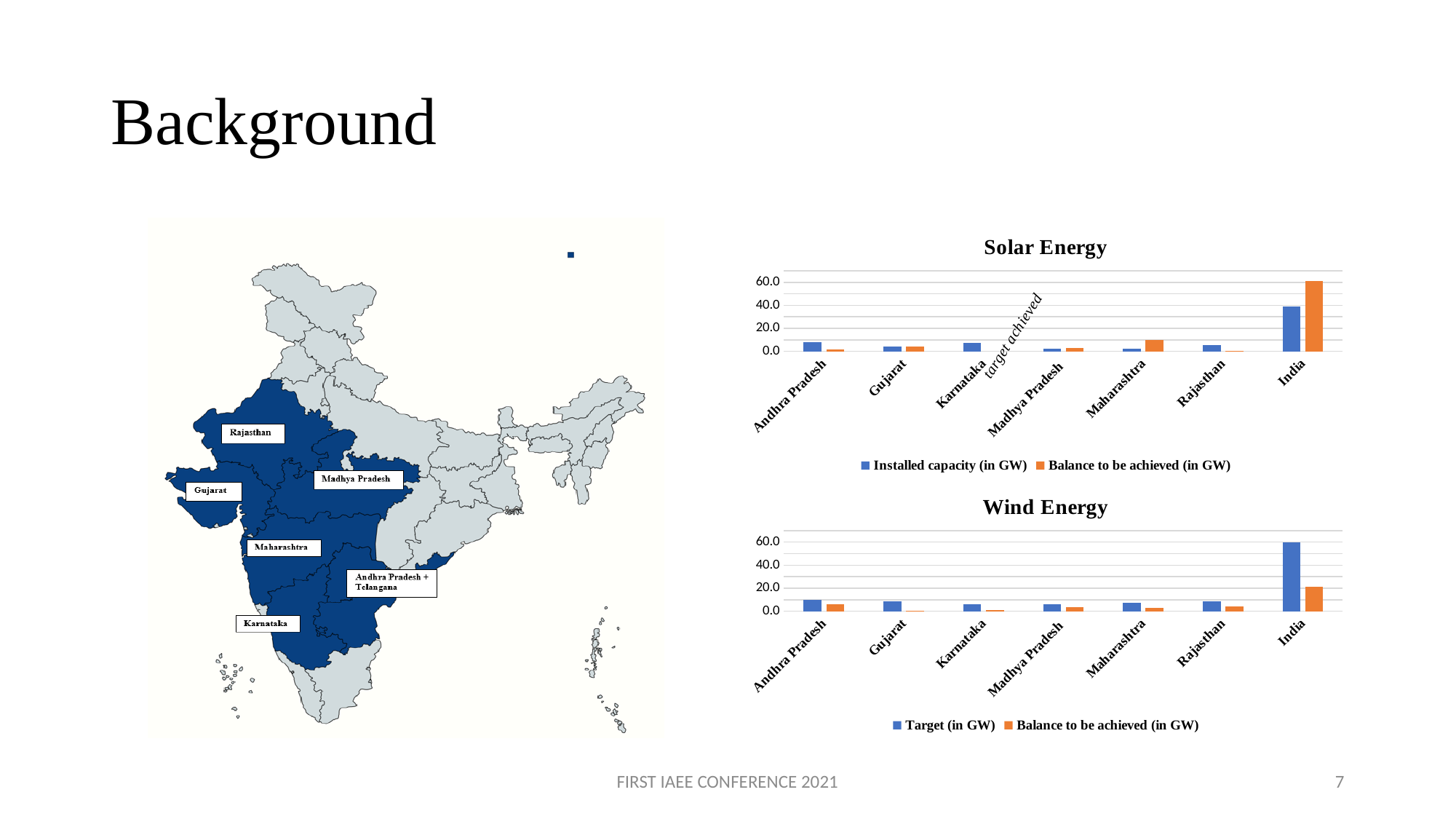
In the Solar Energy chart, which category has the highest Balance to be achieved (in GW)? India How many series does the legend of the Solar Energy chart list? 2 In the Wind Energy chart, which category has the highest Target (in GW)? India What are the two series named in the legend of the Wind Energy chart? Target (in GW) and Balance to be achieved (in GW) In the Wind Energy chart, is the Target (in GW) for India greater or less than 40.0? greater In the Solar Energy chart, for Maharashtra, which is larger: Installed capacity (in GW) or Balance to be achieved (in GW)? Balance to be achieved (in GW) In the Solar Energy chart, for India, which is larger: Installed capacity (in GW) or Balance to be achieved (in GW)? Balance to be achieved (in GW) What kind of chart is the Solar Energy chart? bar chart In the Wind Energy chart, for India, which is larger: Target (in GW) or Balance to be achieved (in GW)? Target (in GW) How many categories are shown on the x axis of the Wind Energy chart? 7 In the Solar Energy chart, is the Balance to be achieved (in GW) for India greater or less than 40.0? greater In the Wind Energy chart, is the Balance to be achieved (in GW) for India greater or less than 40.0? less